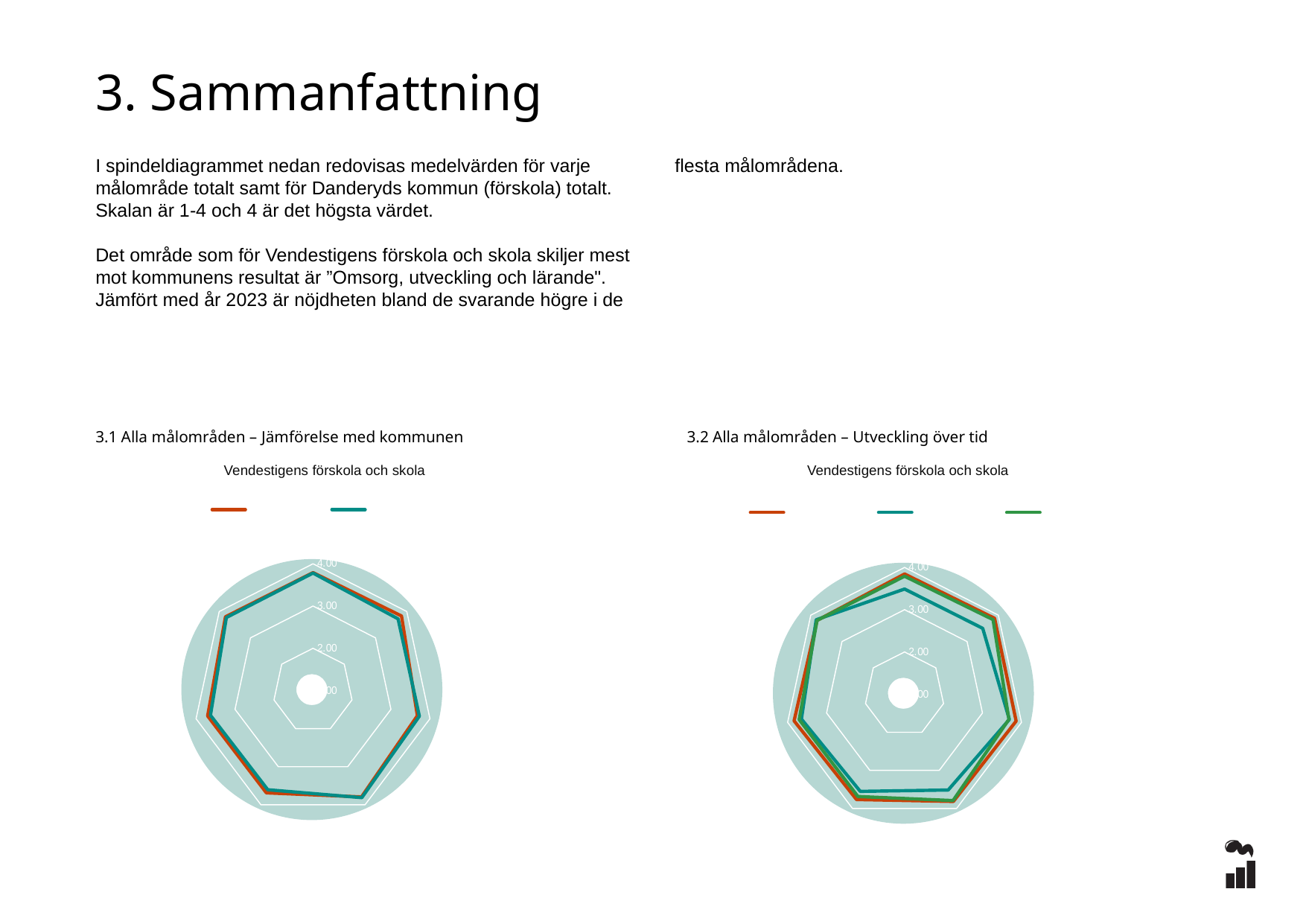
What kind of chart is the right chart under "3.2 Alla målområden – Utveckling över tid"? Radar chart How many axes (categories) does the right radar chart (3.2) have? 7 How many axes (categories) does the left radar chart (3.1) have? 7 In the left chart (3.1), are all plotted values greater or less than 2,00? greater What kind of chart is the left chart under "3.1 Alla målområden – Jämförelse med kommunen"? Radar chart In the right chart (3.2), are all plotted values greater or less than 2,00? greater How many series does the legend of the left chart (3.1) show? 2 What is the highest value shown on the scale of the right radar chart (3.2)? 4,00 How many series does the legend of the right chart (3.2) show? 3 What is the title printed above the left chart (3.1)? Vendestigens förskola och skola